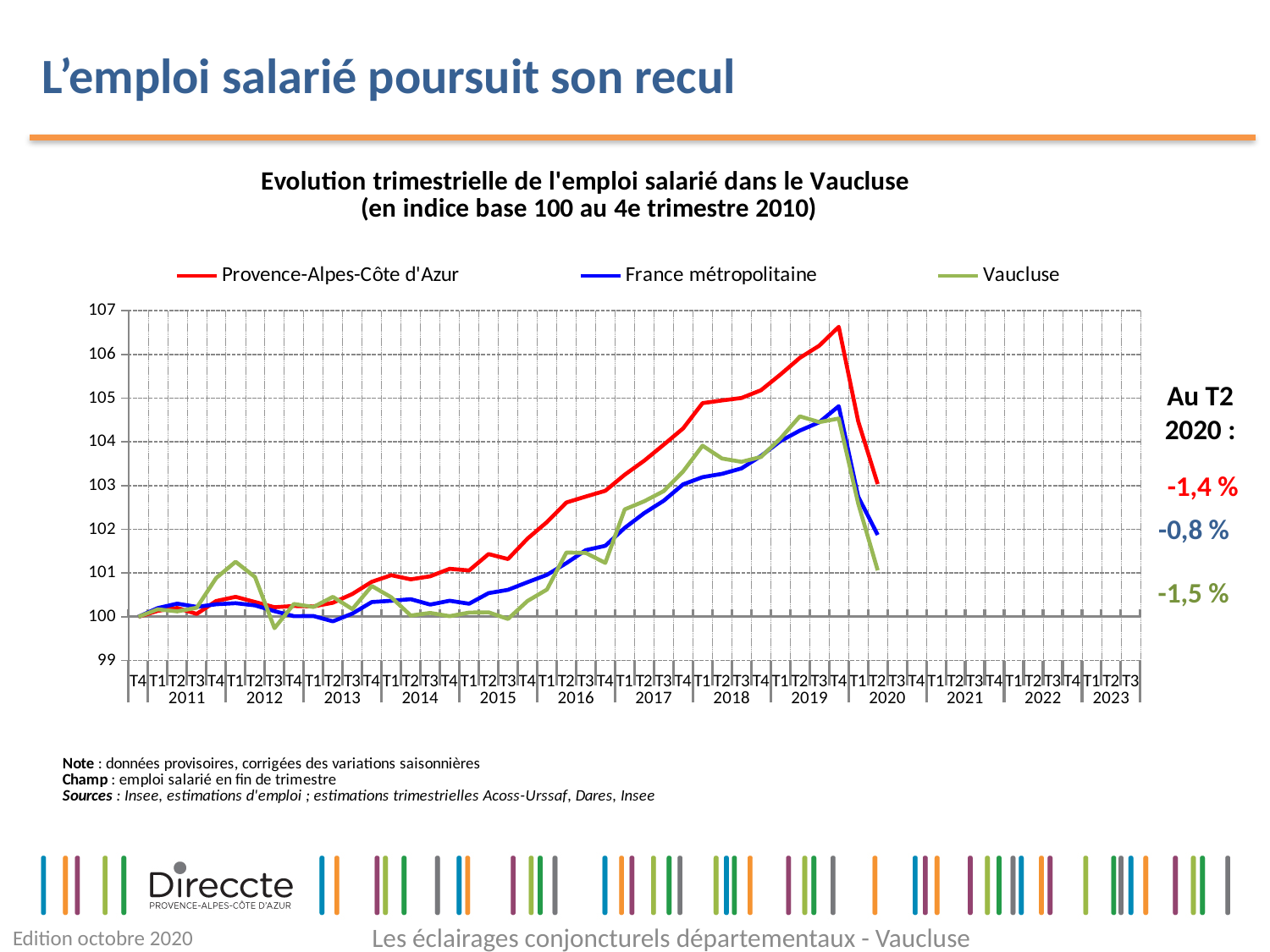
How many series does the legend list? 3 Is the value for Vaucluse at T3 2012 greater or less than 100? less Which series reaches the highest peak on the chart? Provence-Alpes-Côte d'Azur Which three series are listed in the chart legend? Provence-Alpes-Côte d'Azur, France métropolitaine, Vaucluse Between 2016 and 2019, does the Provence-Alpes-Côte d'Azur line rise or fall? rise According to the annotation on the right of the chart, what is the change at T2 2020 shown in red for Provence-Alpes-Côte d'Azur? -1,4 % Is the value for Provence-Alpes-Côte d'Azur at T4 2019 greater or less than 106? greater What kind of chart is shown on the slide? line chart Is the value for France métropolitaine at T2 2020 greater or less than 103? less What is the title of the chart? Evolution trimestrielle de l'emploi salarié dans le Vaucluse (en indice base 100 au 4e trimestre 2010) At T4 2019, which series is higher: Provence-Alpes-Côte d'Azur or France métropolitaine? Provence-Alpes-Côte d'Azur